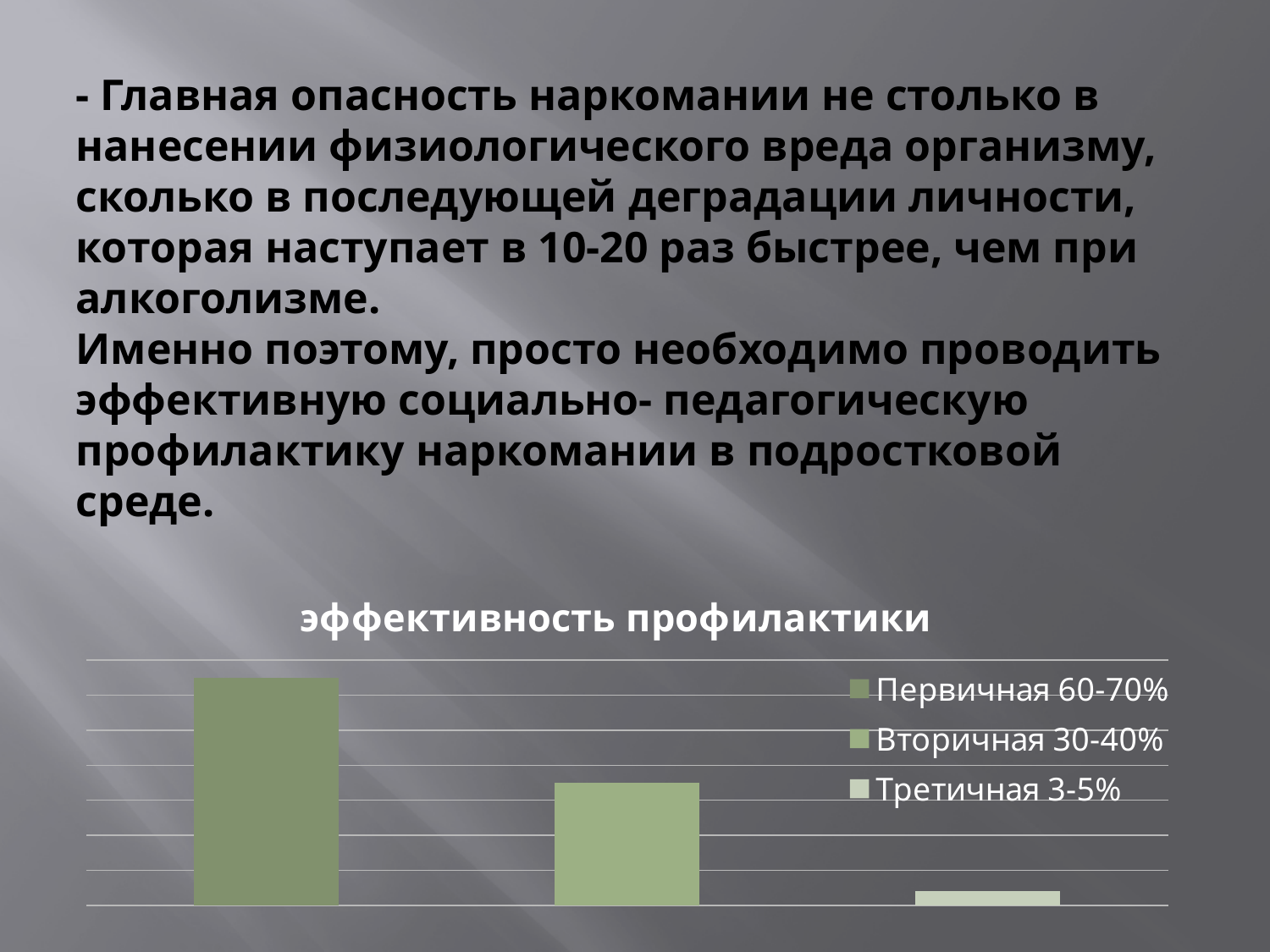
Which bar is taller: "Первичная 60-70%" or "Вторичная 30-40%"? Первичная 60-70% What is the first entry listed in the chart legend? Первичная 60-70% Which series has the shortest bar in the chart? Третичная 3-5% What kind of chart is shown under the title "эффективность профилактики"? bar chart Which series has the tallest bar in the chart? Первичная 60-70% Do the bar heights rise or fall from left to right across the chart? fall How many bars are plotted in the chart? 3 Which bar is taller: "Вторичная 30-40%" or "Третичная 3-5%"? Вторичная 30-40% What is the title of the chart on the slide? эффективность профилактики How many series does the chart legend list? 3